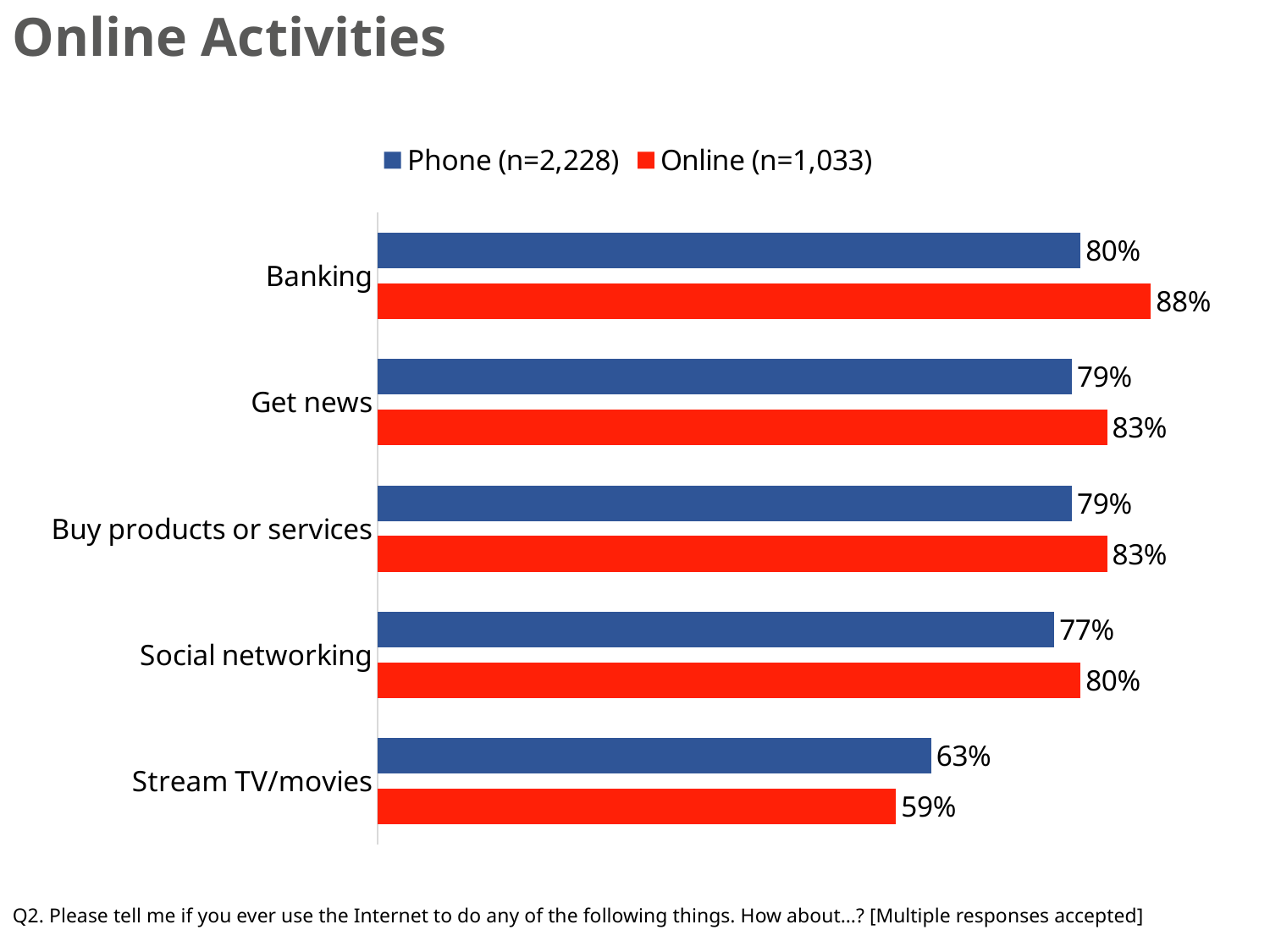
How many series does the legend list? 2 What colour are the Online (n=1,033) bars? Red What is the Phone value for Banking? 80% What is the Online value for Banking? 88% What kind of chart is shown on the slide? Bar chart For Stream TV/movies, which is larger: the Phone value or the Online value? Phone Which category has the highest Online value? Banking What is the Online value for Stream TV/movies? 59% Which category has the lowest Phone value? Stream TV/movies What is the difference between the Online and Phone values for Banking? 8% How many categories are shown on the chart? 5 What is the Phone value for Social networking? 77%